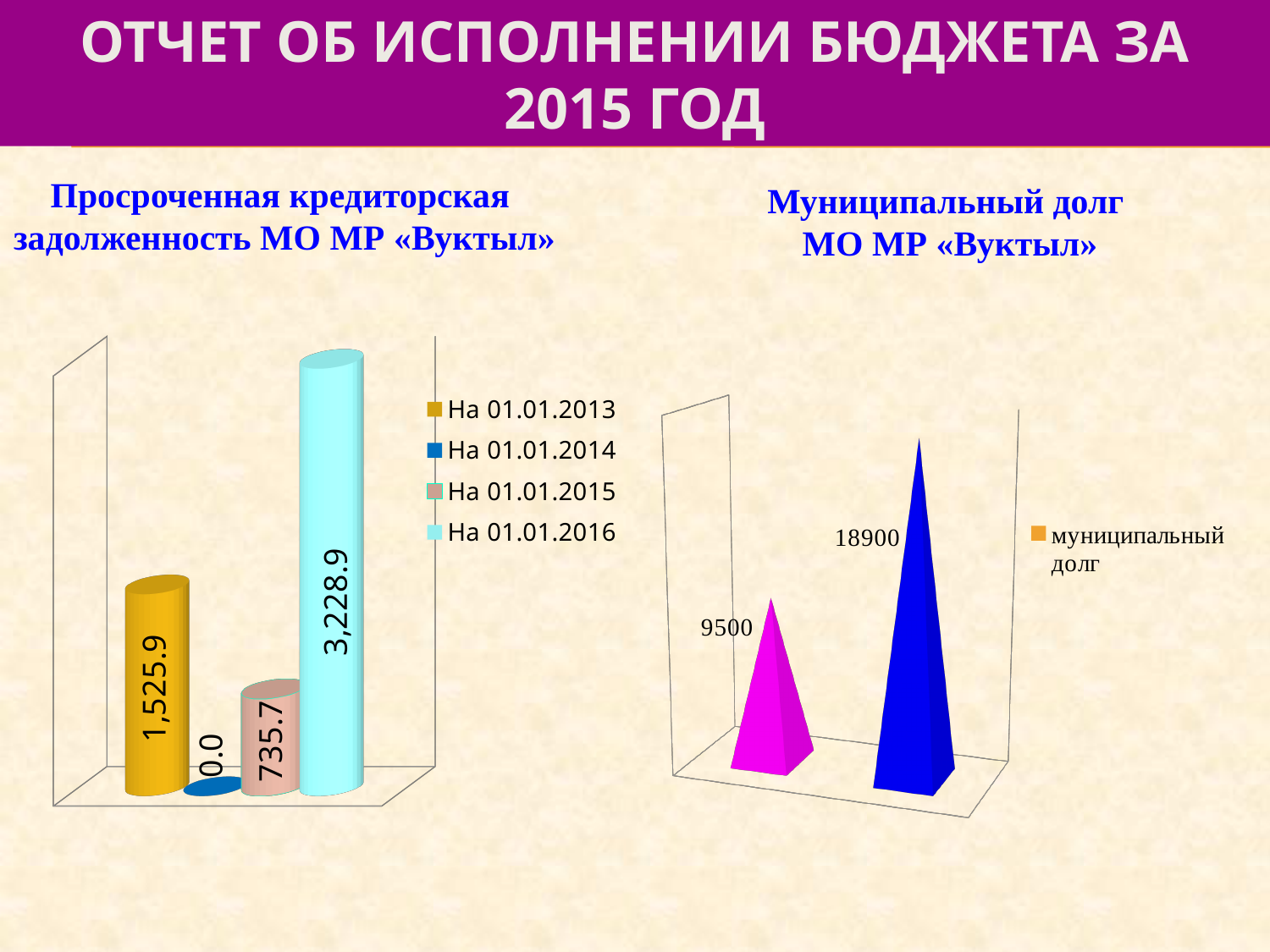
How many entries does the legend of the chart titled «Просроченная кредиторская задолженность МО МР «Вуктыл»» list? 4 In the chart titled «Муниципальный долг МО МР «Вуктыл»», what is the value shown on the blue pyramid on the right? 18900 What kind of chart is the chart titled «Просроченная кредиторская задолженность МО МР «Вуктыл»»? Bar chart In the chart titled «Просроченная кредиторская задолженность МО МР «Вуктыл»», what is the value for На 01.01.2016? 3,228.9 In the chart titled «Просроченная кредиторская задолженность МО МР «Вуктыл»», which is larger: the value for На 01.01.2013 or for На 01.01.2015? На 01.01.2013 In the chart titled «Просроченная кредиторская задолженность МО МР «Вуктыл»», which date has the highest value? На 01.01.2016 In the chart titled «Муниципальный долг МО МР «Вуктыл»», what is the difference between the two plotted values? 9400 In the chart titled «Просроченная кредиторская задолженность МО МР «Вуктыл»», what is the value for На 01.01.2015? 735.7 In the chart titled «Муниципальный долг МО МР «Вуктыл»», what is the value shown on the magenta pyramid on the left? 9500 In the chart titled «Просроченная кредиторская задолженность МО МР «Вуктыл»», what is the value for На 01.01.2013? 1,525.9 In the chart titled «Просроченная кредиторская задолженность МО МР «Вуктыл»», which date has the lowest value? На 01.01.2014 In the chart titled «Просроченная кредиторская задолженность МО МР «Вуктыл»», what is the difference between the values for На 01.01.2016 and На 01.01.2013? 1,703.0